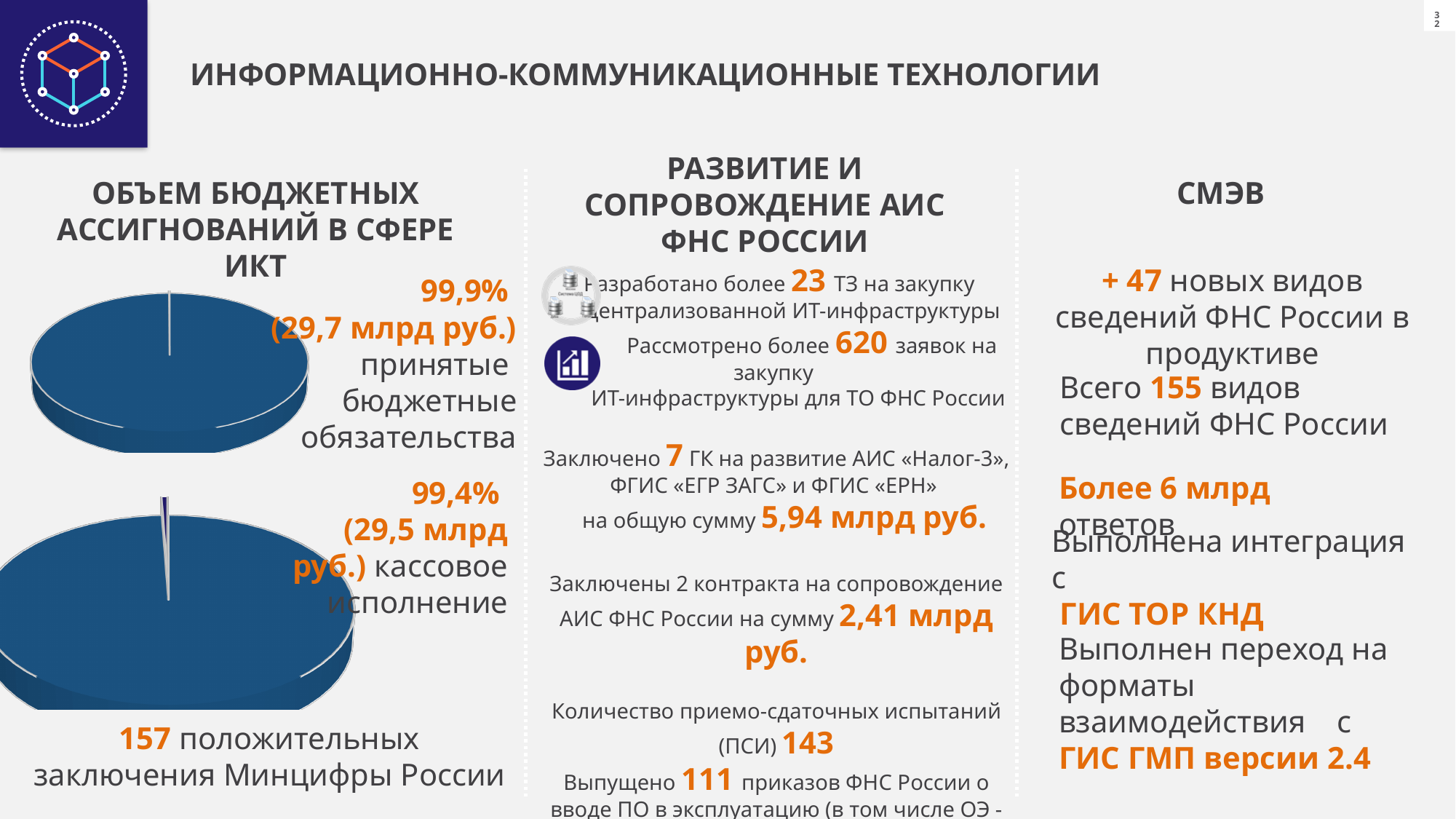
What is the heading above the two pie charts on the left side of the slide? ОБЪЕМ БЮДЖЕТНЫХ АССИГНОВАНИЙ В СФЕРЕ ИКТ What kind of chart is the top chart on the left side of the slide? pie chart What kind of chart is the bottom chart on the left side of the slide? pie chart What is the difference between the share shown for the top pie chart (99,9%) and the share shown for the bottom pie chart (99,4%)? 0,5% How many slices does the bottom pie chart on the left have? 2 Which is larger: the share for принятые бюджетные обязательства in the top pie chart or the share for кассовое исполнение in the bottom pie chart? принятые бюджетные обязательства In the bottom pie chart on the left, what share is shown for кассовое исполнение? 99,4% What amount in rubles is shown next to the top pie chart on the left for принятые бюджетные обязательства? 29,7 млрд руб. How many pie charts are shown on the slide? 2 What amount in rubles is shown next to the bottom pie chart on the left for кассовое исполнение? 29,5 млрд руб. In the top pie chart on the left, what share is shown for принятые бюджетные обязательства? 99,9% How many slices does the top pie chart on the left have? 2